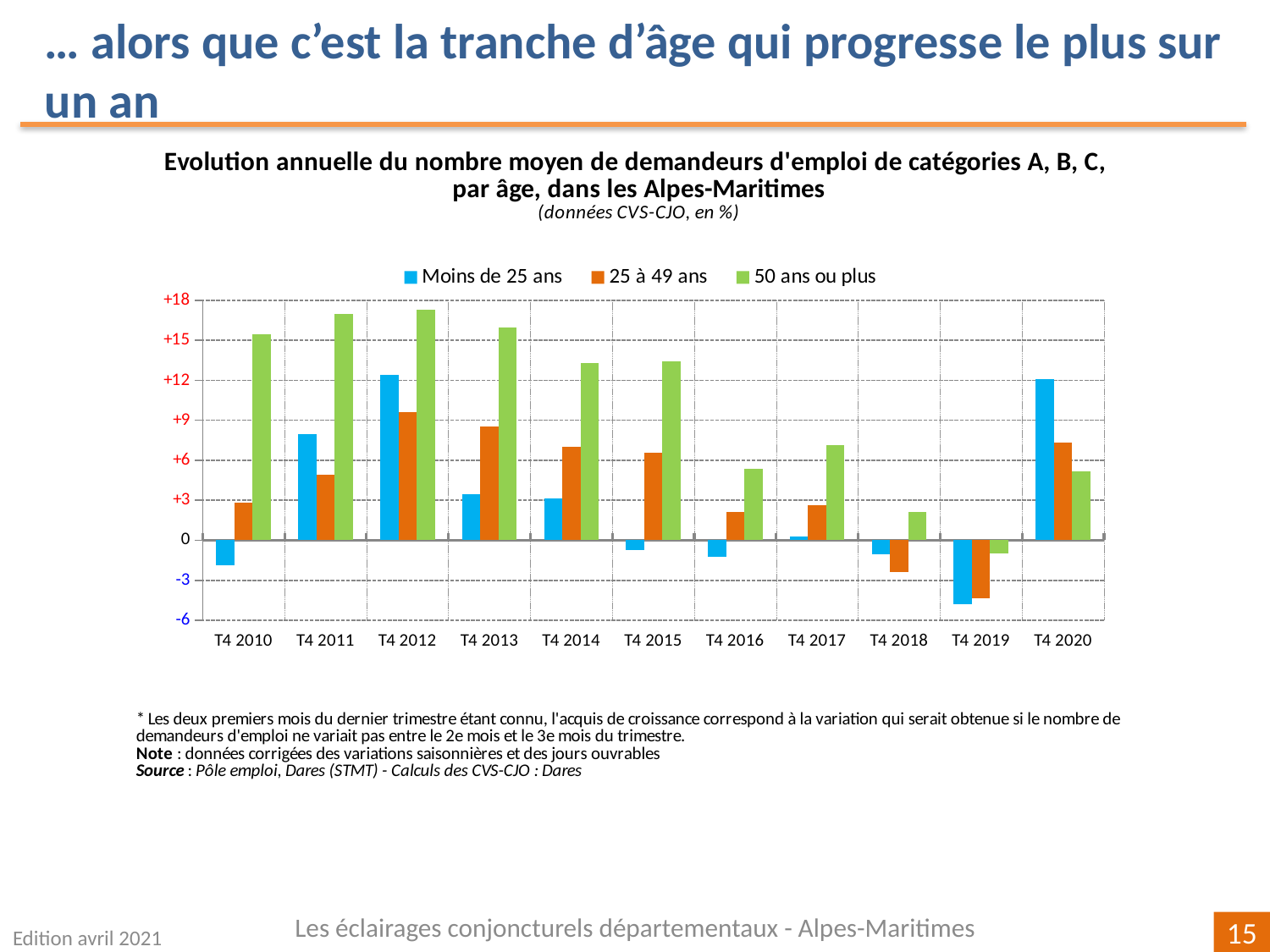
How many series does the legend list? 3 Is the value for 'Moins de 25 ans' in T4 2020 greater or less than +9? greater Does the value for '50 ans ou plus' rise or fall from T4 2015 to T4 2019? Fall In T4 2020, which is larger: the value for 'Moins de 25 ans' or for '50 ans ou plus'? Moins de 25 ans For which quarter is the value for '50 ans ou plus' the lowest? T4 2019 How many quarters (categories) are shown on the x axis? 11 Is the value for '50 ans ou plus' in T4 2010 greater or less than +12? greater For which quarter is the value for 'Moins de 25 ans' the lowest? T4 2019 What kind of chart is shown on the slide? Bar chart For which quarter is the value for '25 à 49 ans' the highest? T4 2012 Which colour represents the '50 ans ou plus' series in the legend? Green Is the value for '25 à 49 ans' in T4 2019 greater or less than -3? less